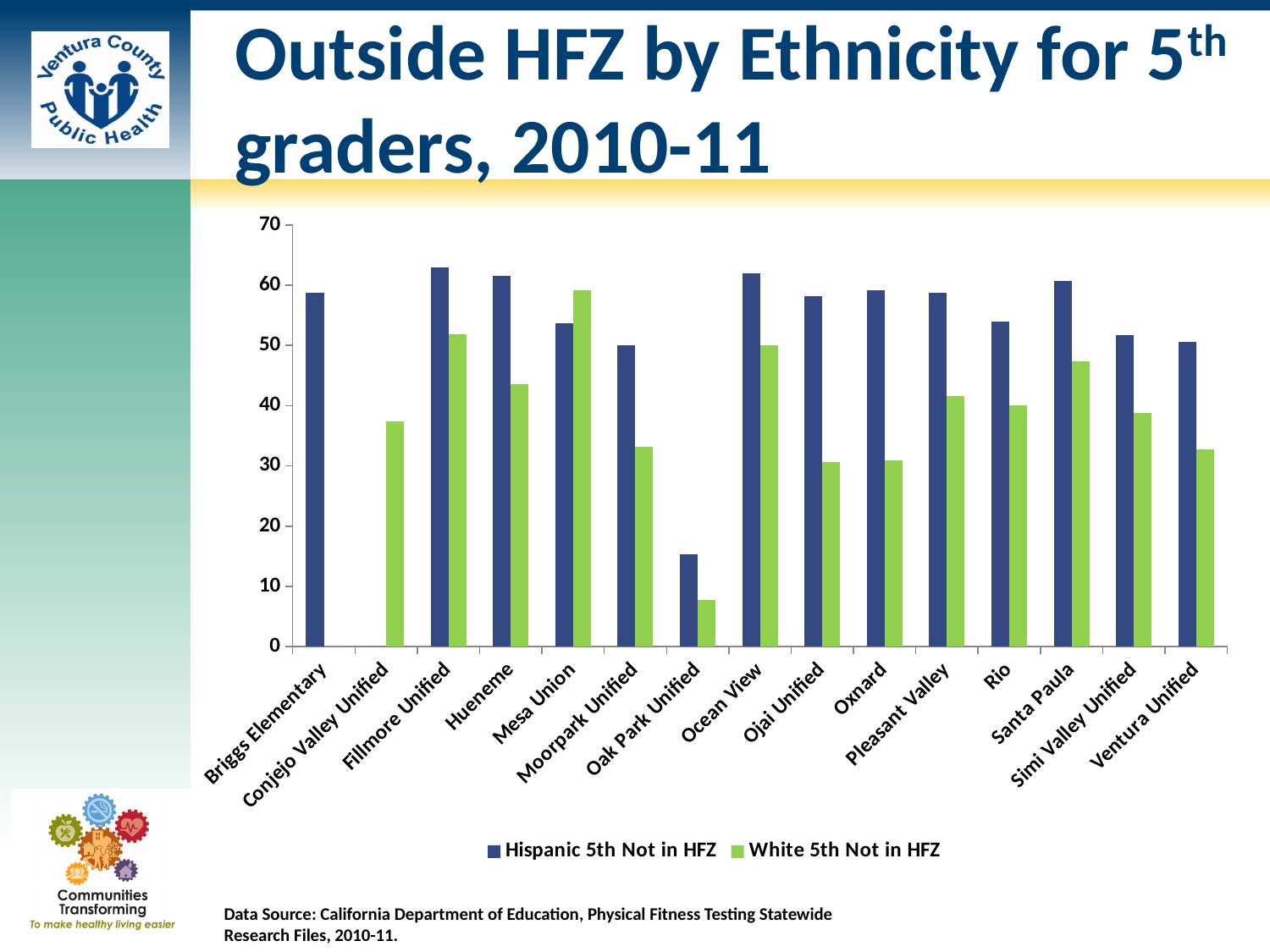
For Mesa Union, which series has the larger value: Hispanic 5th Not in HFZ or White 5th Not in HFZ? White 5th Not in HFZ Is the White 5th Not in HFZ value for Conejo Valley Unified greater or less than 40? less Which district has the highest value for White 5th Not in HFZ? Mesa Union Which is larger: the Hispanic 5th Not in HFZ value for Ojai Unified or for Oak Park Unified? Ojai Unified What kind of chart is shown on the slide? bar chart How many series does the legend list? 2 What colour are the bars for the Hispanic 5th Not in HFZ series? blue Is the Hispanic 5th Not in HFZ value for Oak Park Unified greater or less than 20? less Is the Hispanic 5th Not in HFZ value for Fillmore Unified greater or less than 60? greater How many school districts are shown on the x axis? 15